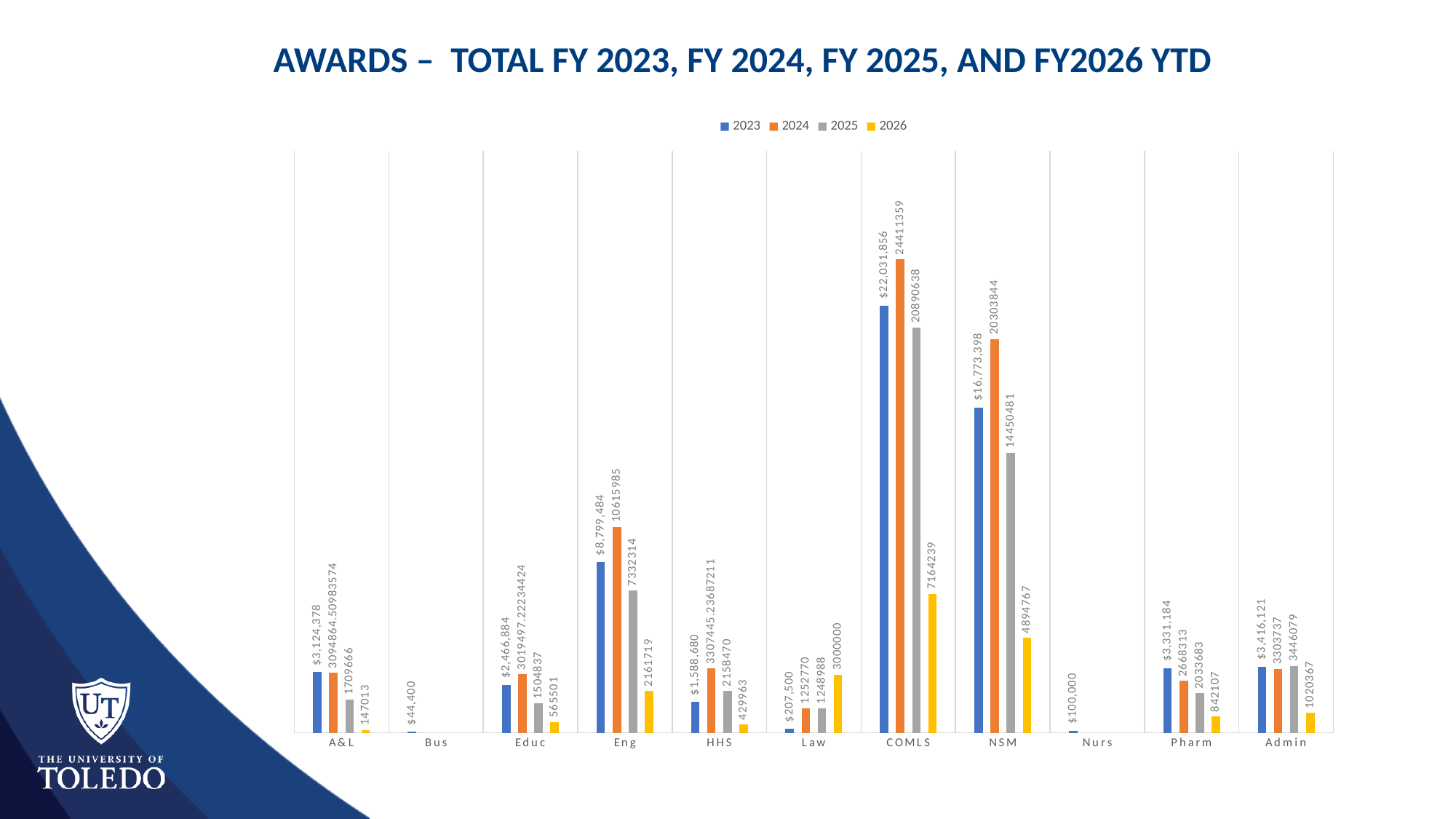
What is the 2023 award value for COMLS? $22,031,856 What is the difference between the 2024 and 2025 award values for COMLS? 3520721 What is the 2025 award value for NSM? 14450481 What kind of chart is shown on the slide? Bar chart Which category has the lowest 2023 award value? Bus What is the difference between the 2026 award values for COMLS and NSM? 2269472 Which category has the highest 2024 award value? COMLS How many categories are shown on the x axis? 11 How many series does the legend list? 4 What is the 2026 award value for Law? 3000000 What is the 2024 award value for Eng? 10615985 For Law, which is larger: the 2024 value or the 2026 value? 2026